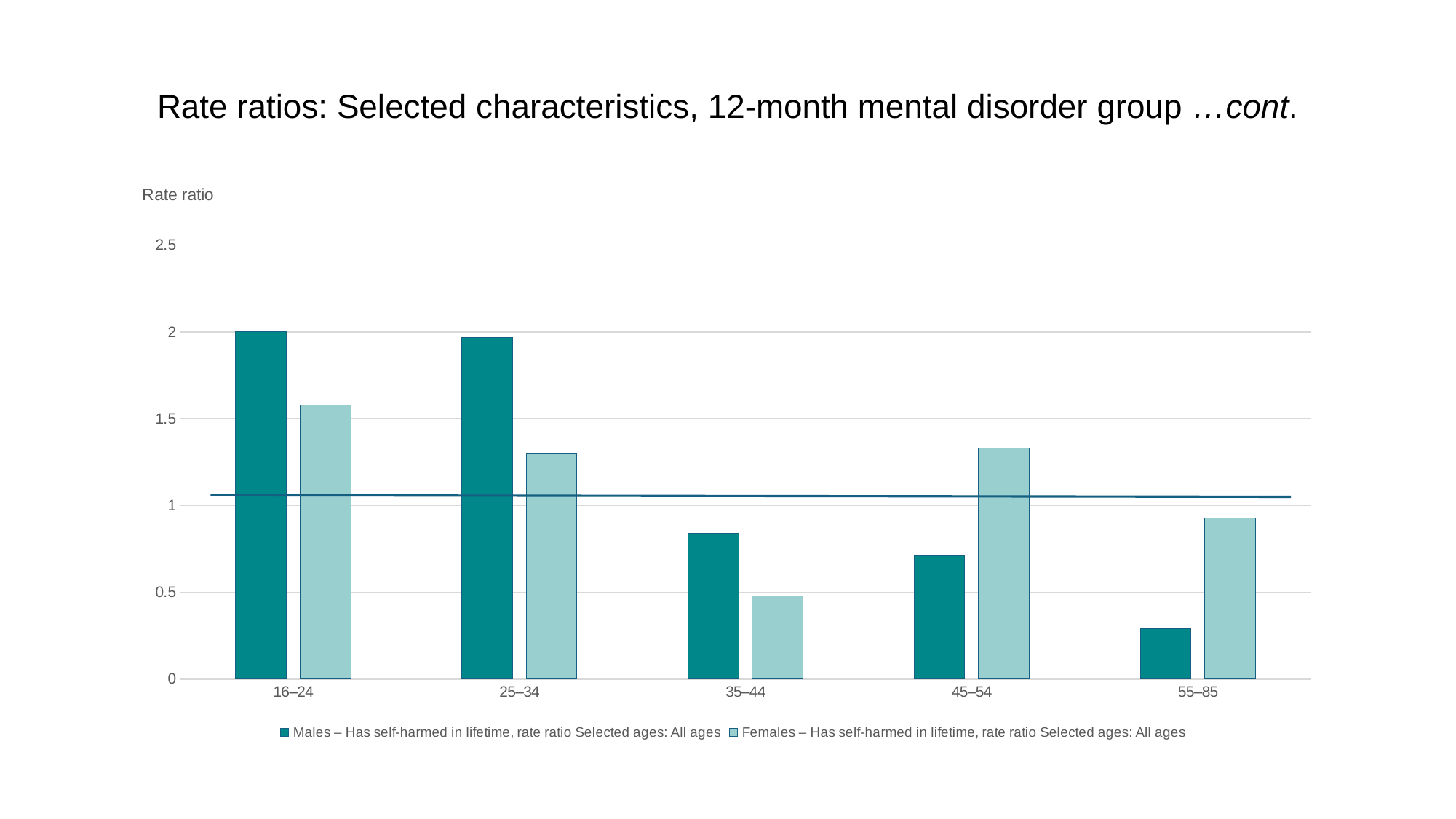
How many series does the legend list? 2 Which age group has the highest rate ratio for Females? 16–24 Is the rate ratio for Females in the 16–24 age group greater or less than 1.5? greater Is the rate ratio for Males in the 55–85 age group greater or less than 0.5? less Is the rate ratio for Males in the 35–44 age group greater or less than 1? less How many age-group categories are shown on the x axis? 5 Which age group has the lowest rate ratio for Males? 55–85 In the 45–54 age group, which series has the larger rate ratio, Males or Females? Females Which age group has the lowest rate ratio for Females? 35–44 Do the Males rate ratios rise or fall as age group increases from 16–24 to 55–85? fall In the 16–24 age group, which series has the larger rate ratio, Males or Females? Males What kind of chart is shown on the slide? bar chart